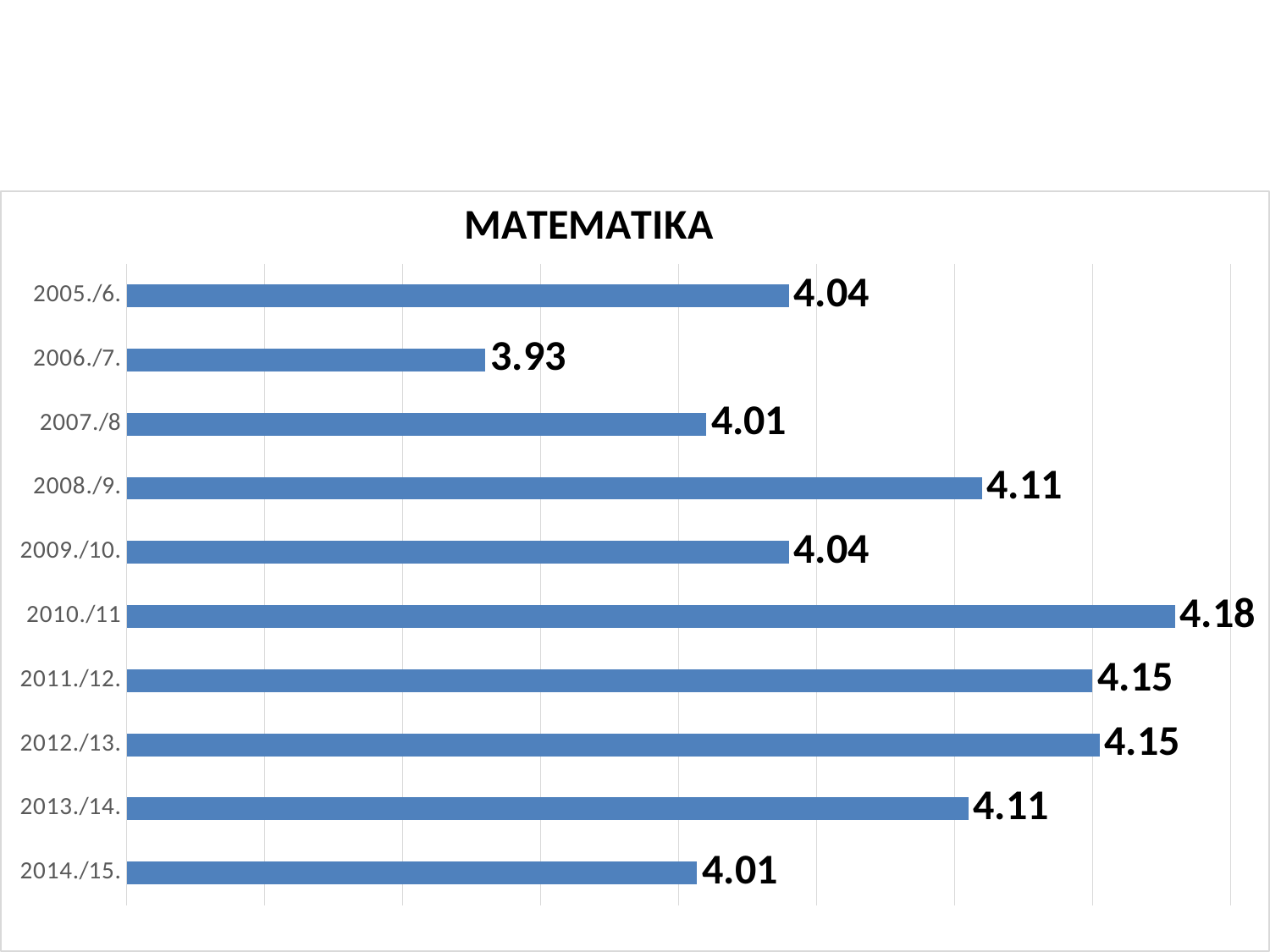
What kind of chart is the MATEMATIKA chart? Bar chart Which is larger in the MATEMATIKA chart, the value for 2008./9. or the value for 2007./8? 2008./9. Which school year has the lowest value in the MATEMATIKA chart? 2006./7. What is the difference between the values for 2008./9. and 2007./8 in the MATEMATIKA chart? 0.10 What is the difference between the highest value (2010./11) and the lowest value (2006./7.) in the MATEMATIKA chart? 0.25 How many school years are shown in the MATEMATIKA chart? 10 Do the values in the MATEMATIKA chart rise or fall from 2010./11 to 2014./15.? Fall Which school year has the highest value in the MATEMATIKA chart? 2010./11 What is the value for 2014./15. in the MATEMATIKA chart? 4.01 What is the value for 2010./11 in the MATEMATIKA chart? 4.18 What is the value for 2006./7. in the MATEMATIKA chart? 3.93 What is the value for 2013./14. in the MATEMATIKA chart? 4.11